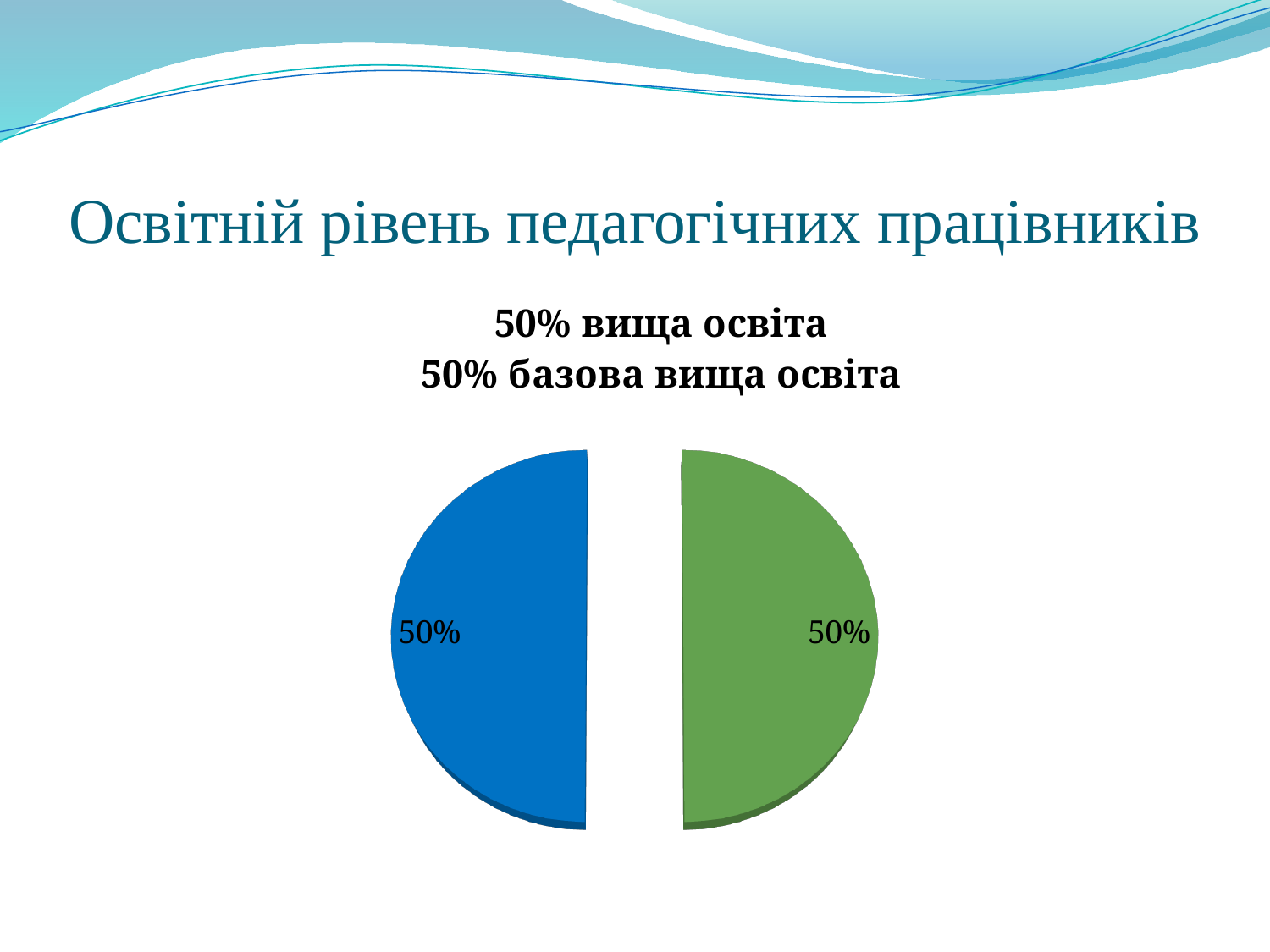
What do the two slices of the pie chart add up to? 100% What colours are the two slices of the pie chart? blue and green What type of chart is shown on the slide? pie chart What value is printed on the green slice of the pie chart? 50% According to the text above the chart, what percentage of teaching staff have базова вища освіта? 50% What share of the pie does the green slice represent? 50% Which slice of the pie chart is larger, the blue one or the green one? They are equal How many slices does the pie chart have? 2 According to the text above the chart, what percentage of teaching staff have вища освіта? 50% What is the title of the slide containing the pie chart? Освітній рівень педагогічних працівників What is the difference between the blue slice and the green slice of the pie chart? 0% What value is printed on the blue slice of the pie chart? 50%